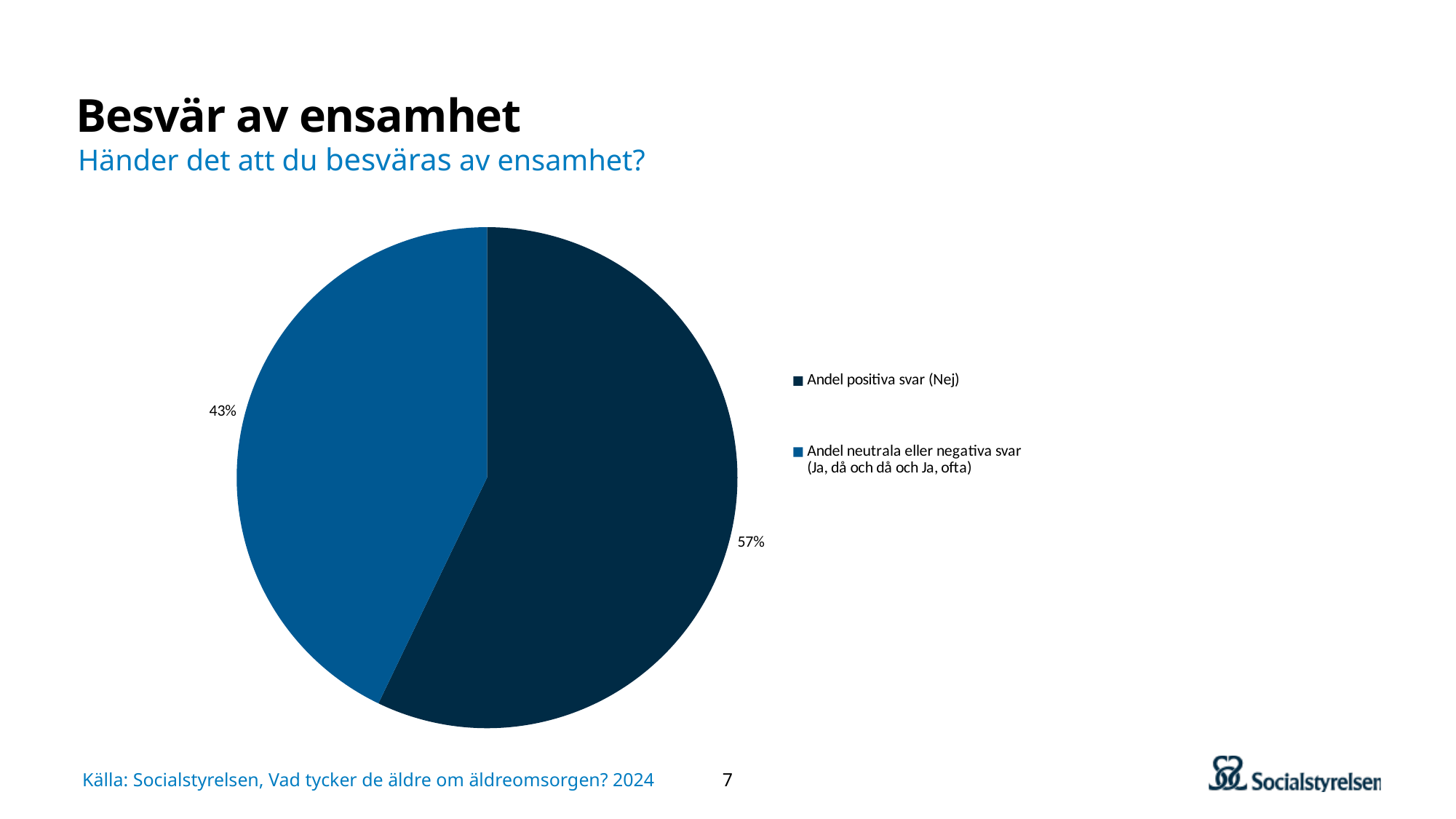
What question is shown as the subtitle above the chart? Händer det att du besväras av ensamhet? What share of the pie is 'Andel positiva svar (Nej)'? 57% How many slices does the pie chart have? 2 What share of the pie is 'Andel neutrala eller negativa svar (Ja, då och då och Ja, ofta)'? 43% Which slice of the pie is the smallest? Andel neutrala eller negativa svar (Ja, då och då och Ja, ofta) Which is larger: the share for 'Andel positiva svar (Nej)' or the share for 'Andel neutrala eller negativa svar'? Andel positiva svar (Nej) What kind of chart is shown on the slide? pie chart What is the difference in percentage points between the 'Andel positiva svar (Nej)' slice and the 'Andel neutrala eller negativa svar' slice? 14 percentage points How many entries does the legend list? 2 Which slice of the pie is the largest? Andel positiva svar (Nej) Which legend entry is shown in the lighter blue colour? Andel neutrala eller negativa svar (Ja, då och då och Ja, ofta)